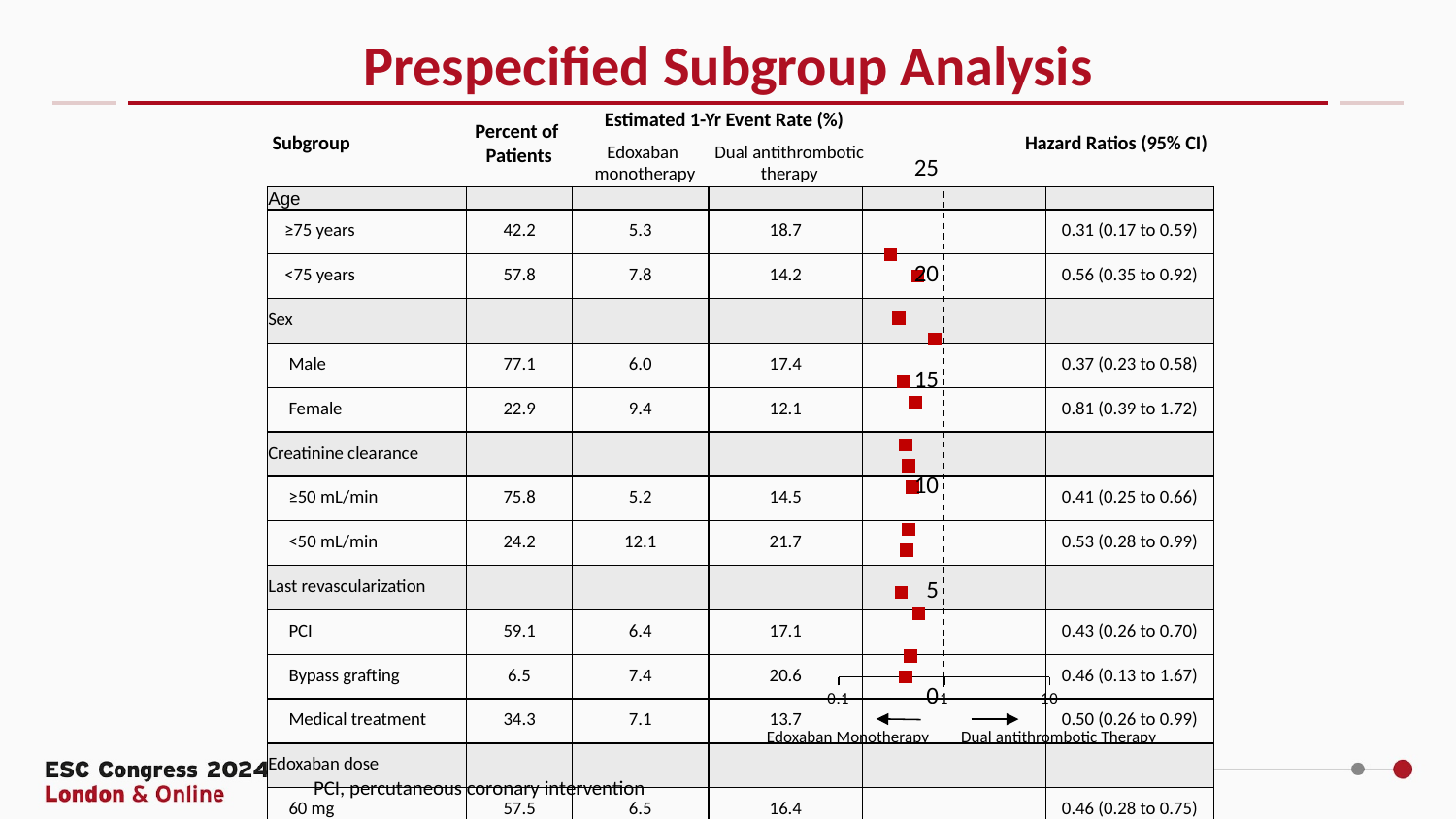
What is the hazard ratio (95% CI) for the Female subgroup? 0.81 (0.39 to 1.72) Which subgroup has the lowest hazard ratio point estimate? ≥75 years Is the hazard ratio point estimate for the <50 mL/min subgroup greater or less than 1? less What label appears under the left arrow on the forest plot's x axis? Edoxaban Monotherapy What is the estimated 1-year event rate for dual antithrombotic therapy in the <50 mL/min subgroup? 21.7 Which has the larger hazard ratio point estimate, Male or Female? Female Which subgroup has the highest hazard ratio point estimate? Female What is the hazard ratio (95% CI) for the Bypass grafting subgroup? 0.46 (0.13 to 1.67) What is the difference between the hazard ratio point estimates for Female and Male? 0.44 What is the hazard ratio (95% CI) for the ≥75 years subgroup? 0.31 (0.17 to 0.59) What colour are the point-estimate markers in the forest plot? Red What kind of chart is overlaid on the table on the right side of the slide? Forest plot